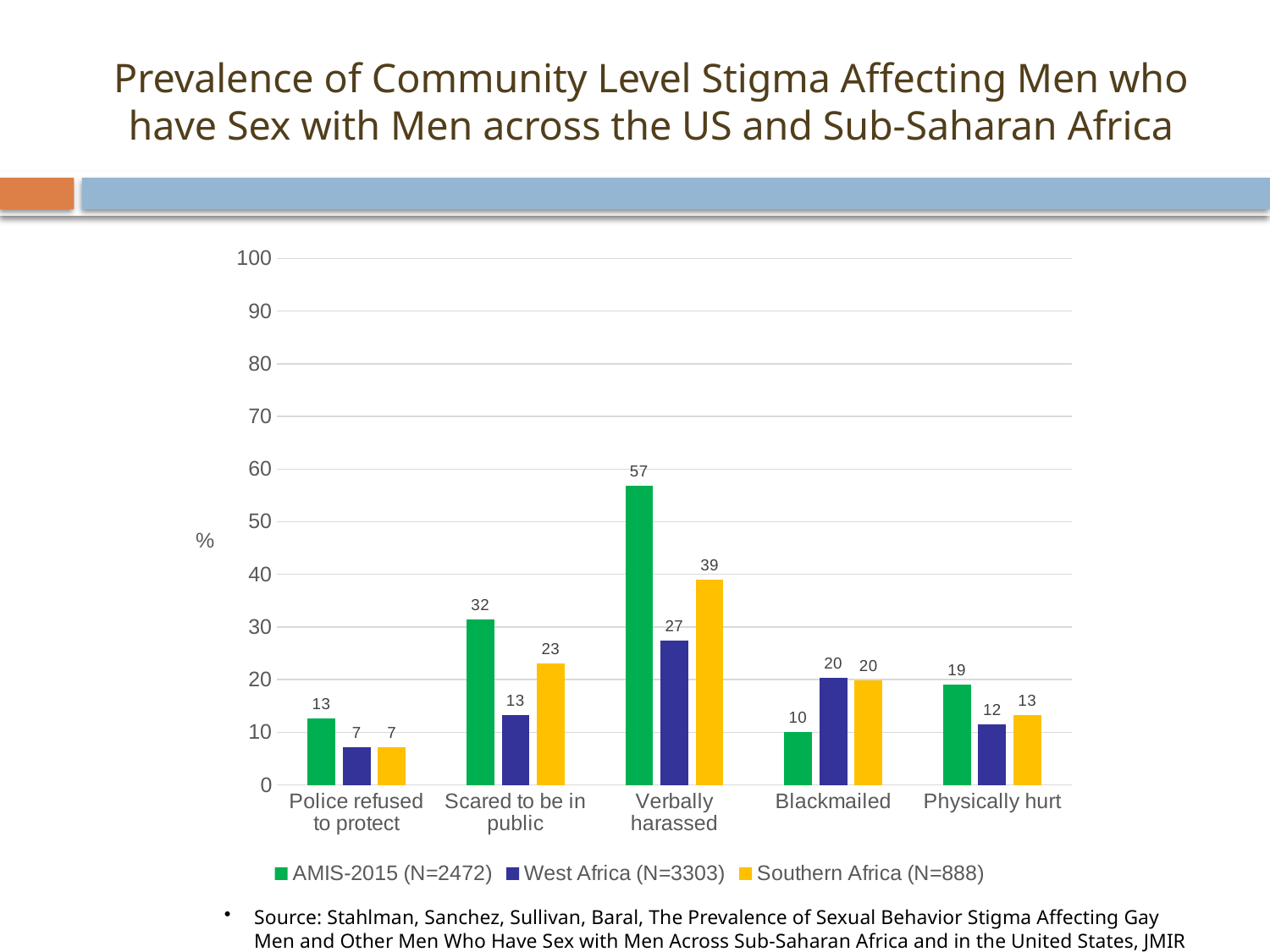
What is the difference between the AMIS-2015 (N=2472) and Southern Africa (N=888) values in the Verbally harassed category? 18 In the Blackmailed category, which is larger: the AMIS-2015 (N=2472) value or the West Africa (N=3303) value? West Africa (N=3303) Which category has the lowest value for West Africa (N=3303)? Police refused to protect What kind of chart is shown on the slide? bar chart What is the value for Southern Africa (N=888) in the Scared to be in public category? 23 What label is shown on the y axis? % What is the value for AMIS-2015 (N=2472) in the Verbally harassed category? 57 What is the value for West Africa (N=3303) in the Physically hurt category? 12 Is the value for AMIS-2015 (N=2472) in the Scared to be in public category greater or less than 30? greater Which category has the highest value for AMIS-2015 (N=2472)? Verbally harassed How many categories are shown on the x axis? 5 How many series does the legend list? 3